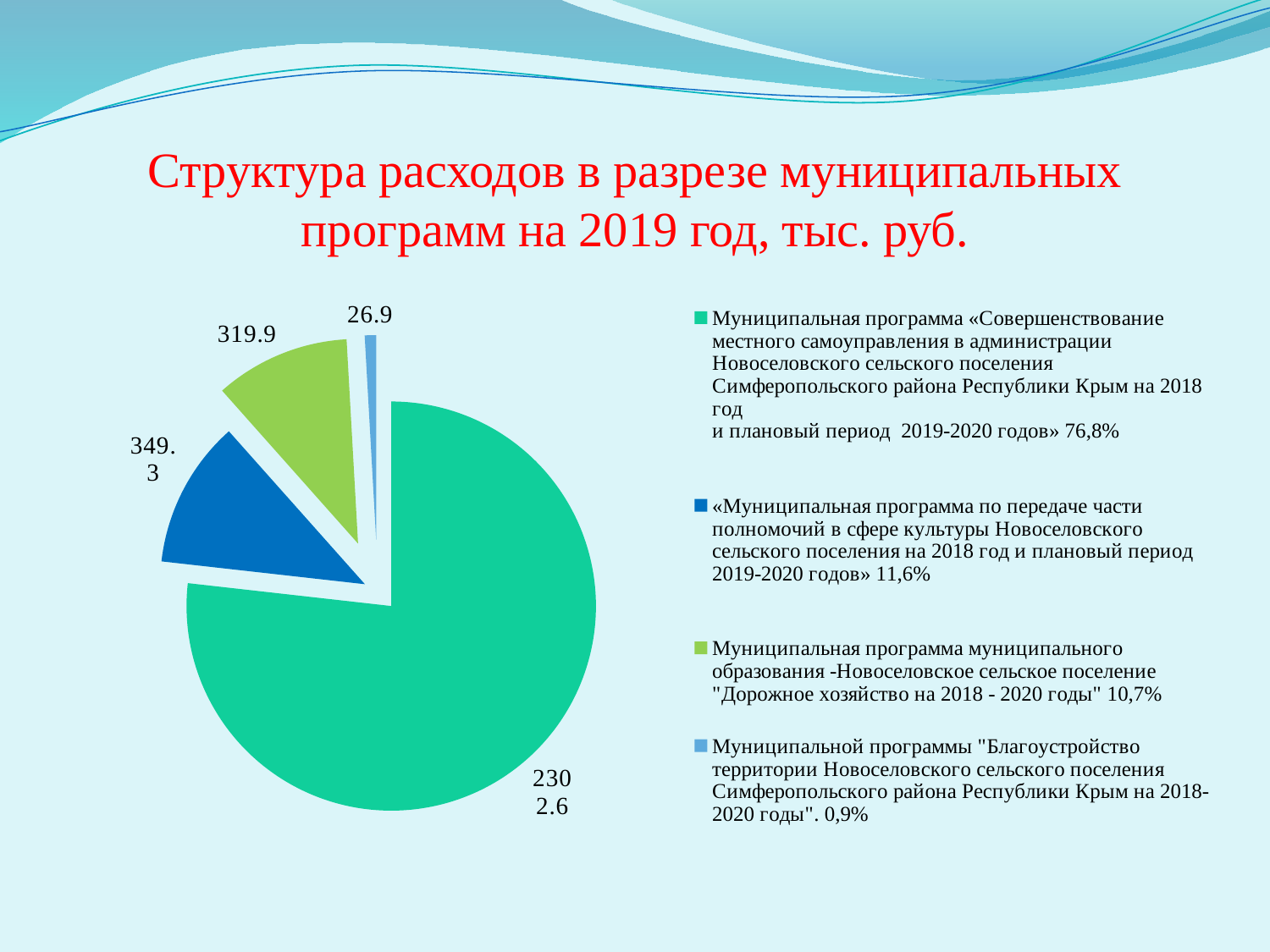
What is the value of the largest slice of the pie chart? 2302.6 What unit of measurement is stated in the chart title? тыс. руб. Which is larger: the slice labelled 349.3 or the slice labelled 319.9? 349.3 How many entries does the legend list? 4 What is the difference between the slice labelled 349.3 and the slice labelled 319.9? 29.4 What is the value of the smallest slice of the pie chart? 26.9 What kind of chart is shown on the slide? pie chart What share of the pie does the program «Совершенствование местного самоуправления...» account for, according to the legend? 76,8% What share of the pie does the program «Благоустройство территории Новоселовского сельского поселения...» account for, according to the legend? 0,9% How many slices does the pie chart have? 4 What value is shown for the slice of the program on transferring powers in the sphere of culture (dark blue)? 349.3 What value is shown for the slice of the program «Дорожное хозяйство на 2018 - 2020 годы» (light green)? 319.9